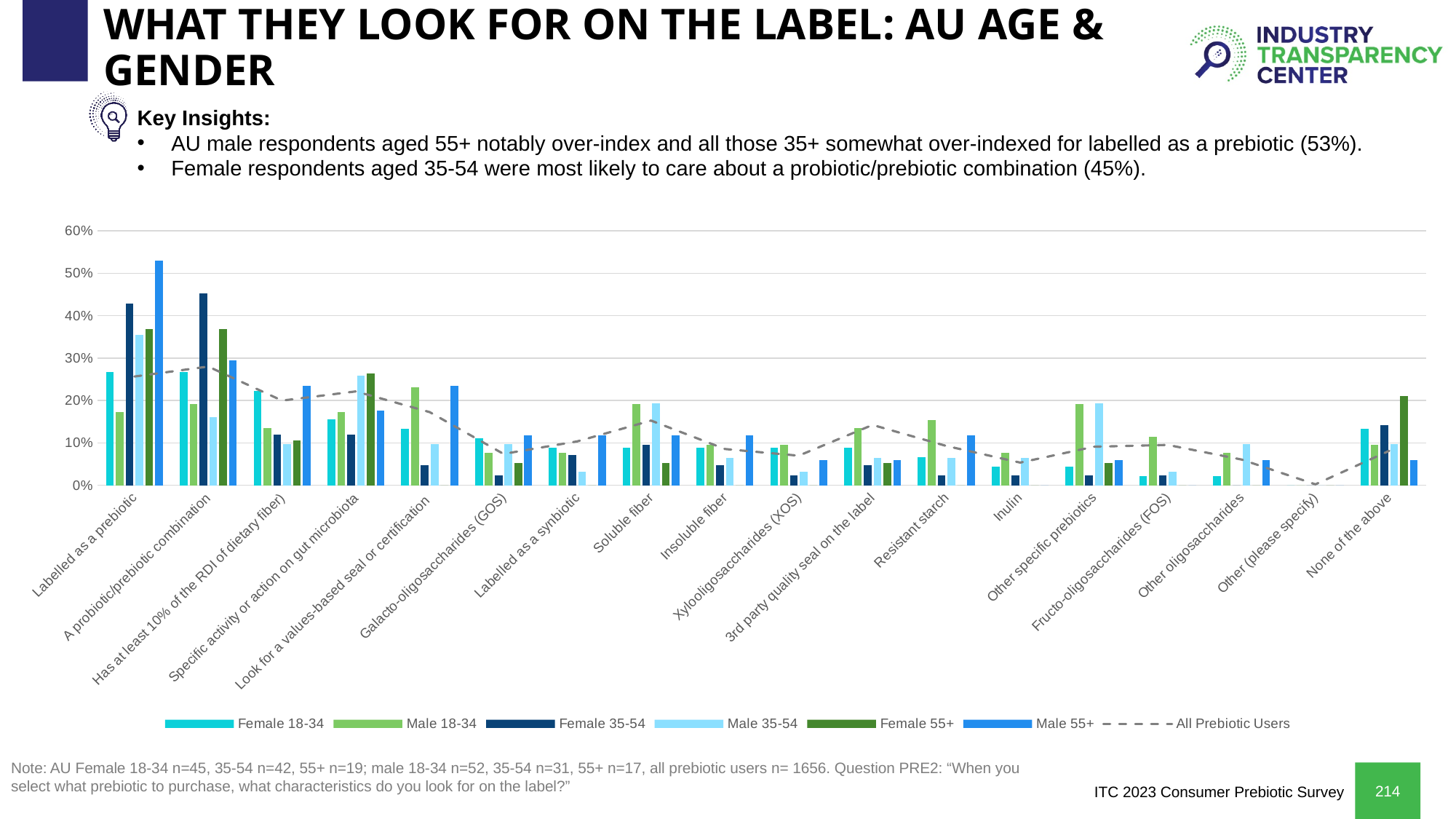
Is the value for Male 55+ on 'Labelled as a prebiotic' greater or less than 50%? greater What kind of chart is shown on the slide? Combination bar and line chart How many label characteristics (categories) are shown on the x axis? 18 Which category has the tallest bar in the chart? Labelled as a prebiotic Which series is represented by the dashed grey line? All Prebiotic Users For 'None of the above', which is larger: Female 55+ or Male 18-34? Female 55+ How many series does the legend list? 7 Is the value for Female 35-54 on 'A probiotic/prebiotic combination' greater or less than 40%? greater Which series has the highest bar for 'Labelled as a prebiotic'? Male 55+ Does the dashed 'All Prebiotic Users' line generally rise or fall from left to right across the categories? Fall Which category has the lowest values overall, with almost no bars visible? Other (please specify)